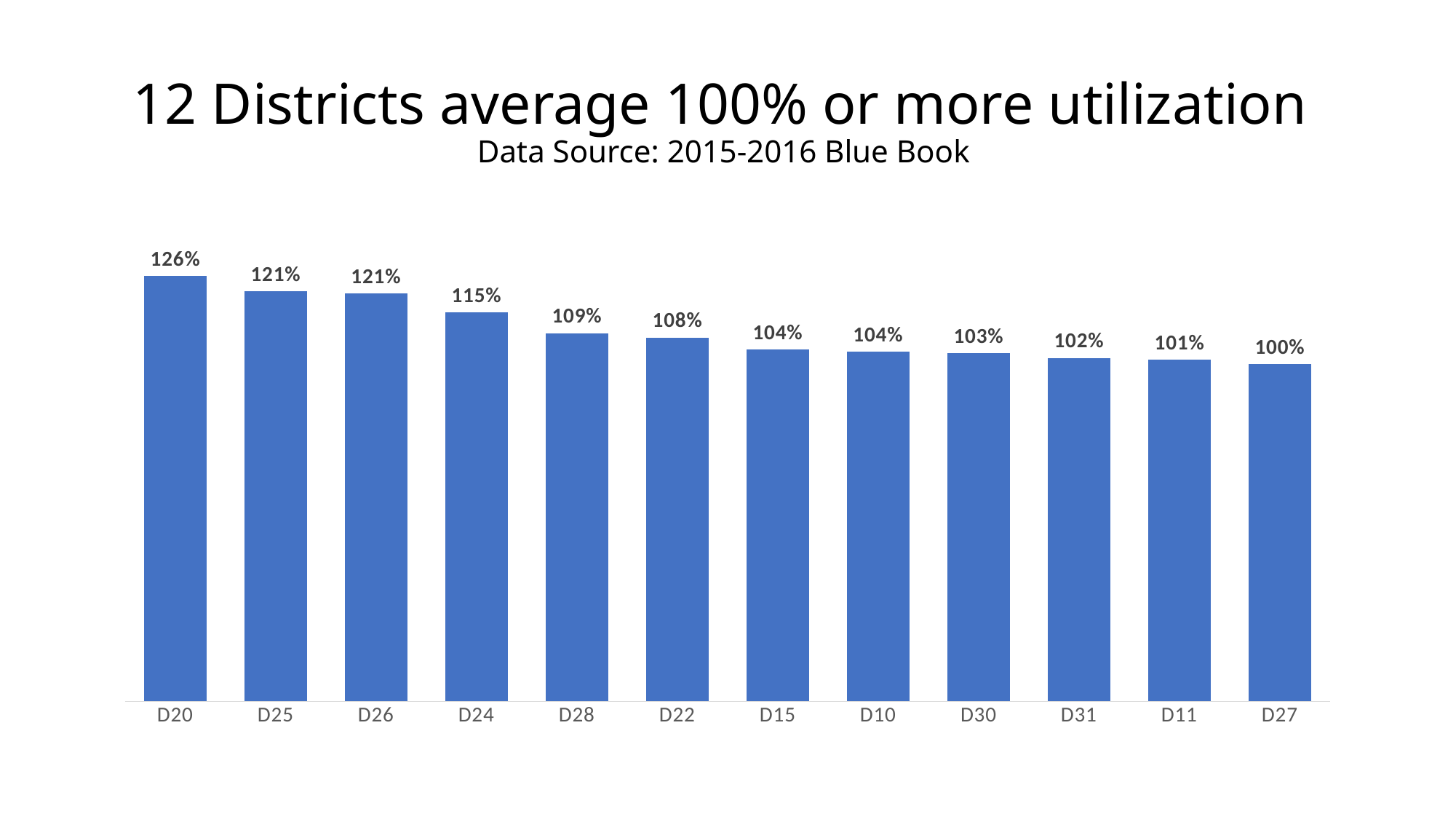
What kind of chart is shown on the slide? Bar chart Do the values rise or fall from left to right along the x axis? Fall What is the utilization value for D20? 126% Which has a higher utilization, D28 or D15? D28 What is the utilization value for D24? 115% How many districts are shown in the chart? 12 What is the utilization value for D27? 100% What is the utilization value for D30? 103% Which district has the lowest utilization? D27 Which district has the highest utilization? D20 What is the difference between the utilization of D20 and D27? 26% What is the difference between the utilization of D24 and D28? 6%